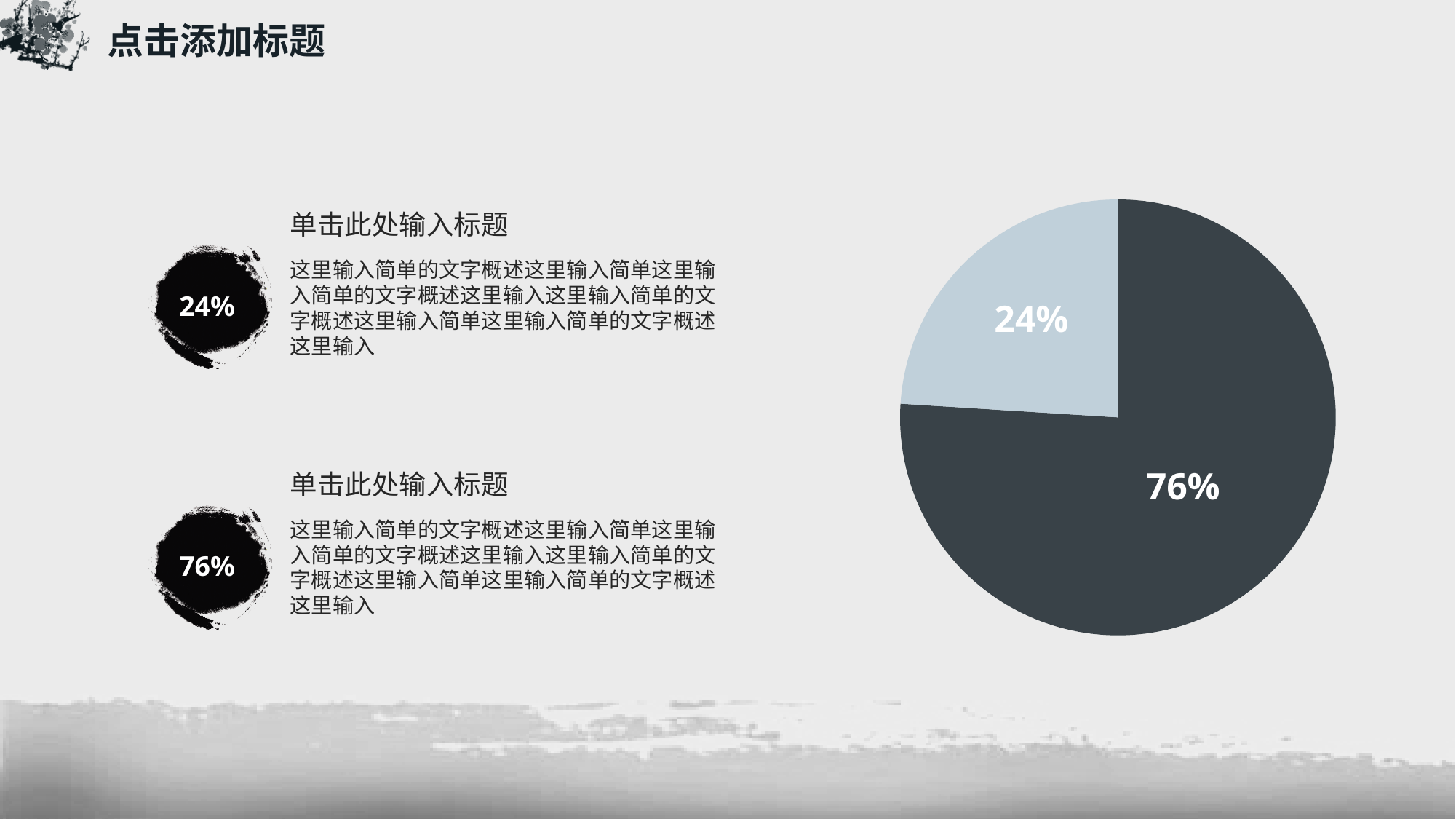
Is the dark slice of the pie chart larger or smaller than the light blue slice? larger What share of the pie does the dark slice represent? 76% What kind of chart is shown on the right side of the slide? pie chart What value is labelled on the dark slice of the pie chart? 76% What share of the pie does the light blue slice represent? 24% How many slices does the pie chart have? 2 Which slice of the pie chart is the smallest, the dark one or the light blue one? the light blue one What colour is the slice labelled 76% in the pie chart? dark grey What is the difference between the two slice values in the pie chart? 52% Does the pie chart show a legend? No Which slice of the pie chart is the largest, the dark one or the light blue one? the dark one What value is labelled on the light blue slice of the pie chart? 24%